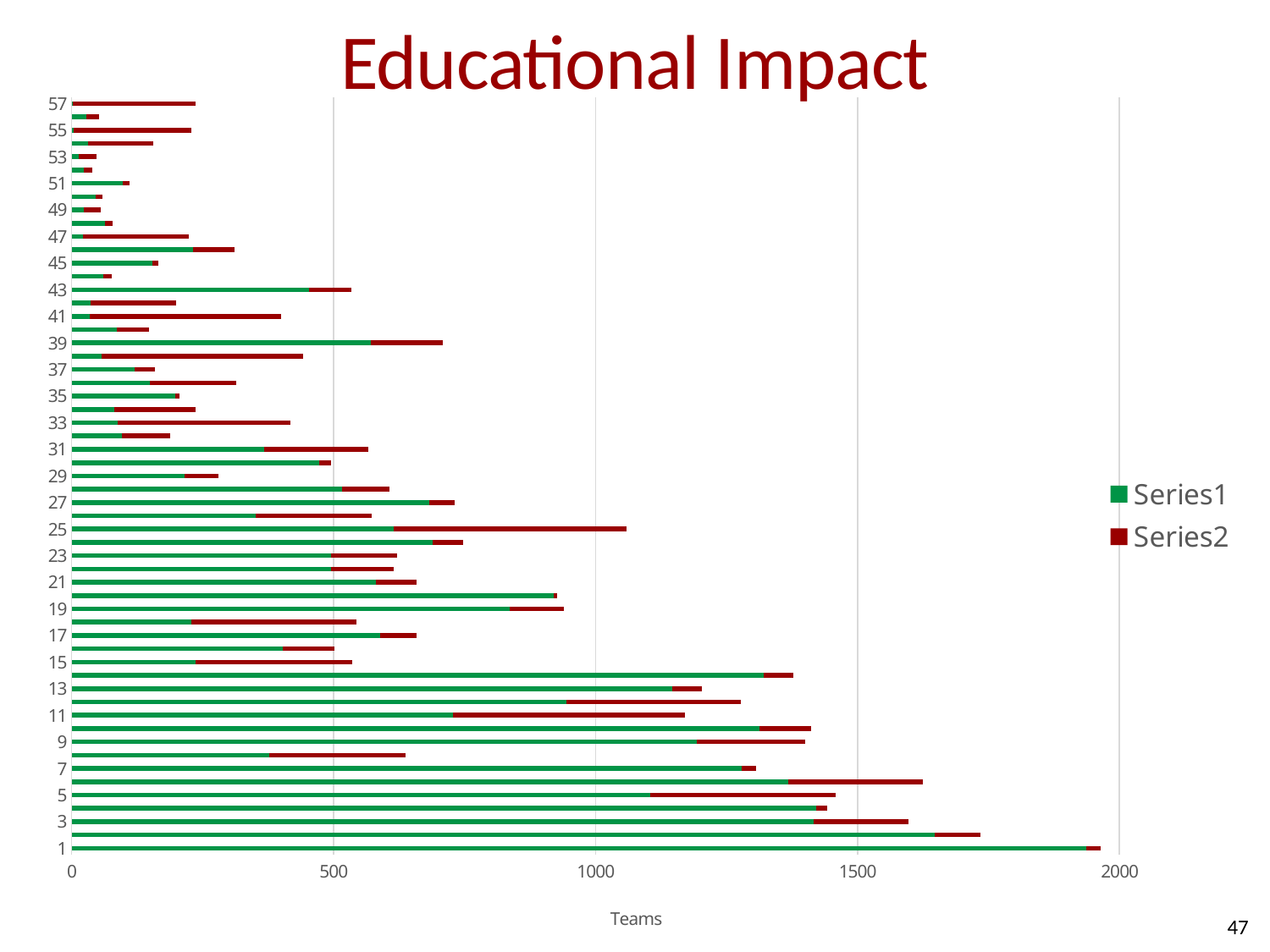
Which category has the longest bar overall? 1 What kind of chart is shown on the slide? bar chart Is the total value for category 13 greater or less than 1000? greater Is the total value for category 21 greater or less than 1000? less What is the title of the chart? Educational Impact Is the total value for category 1 greater or less than 1500? greater How many series does the legend list? 2 What is the label on the x axis of the chart? Teams Which has the larger total value, category 1 or category 57? 1